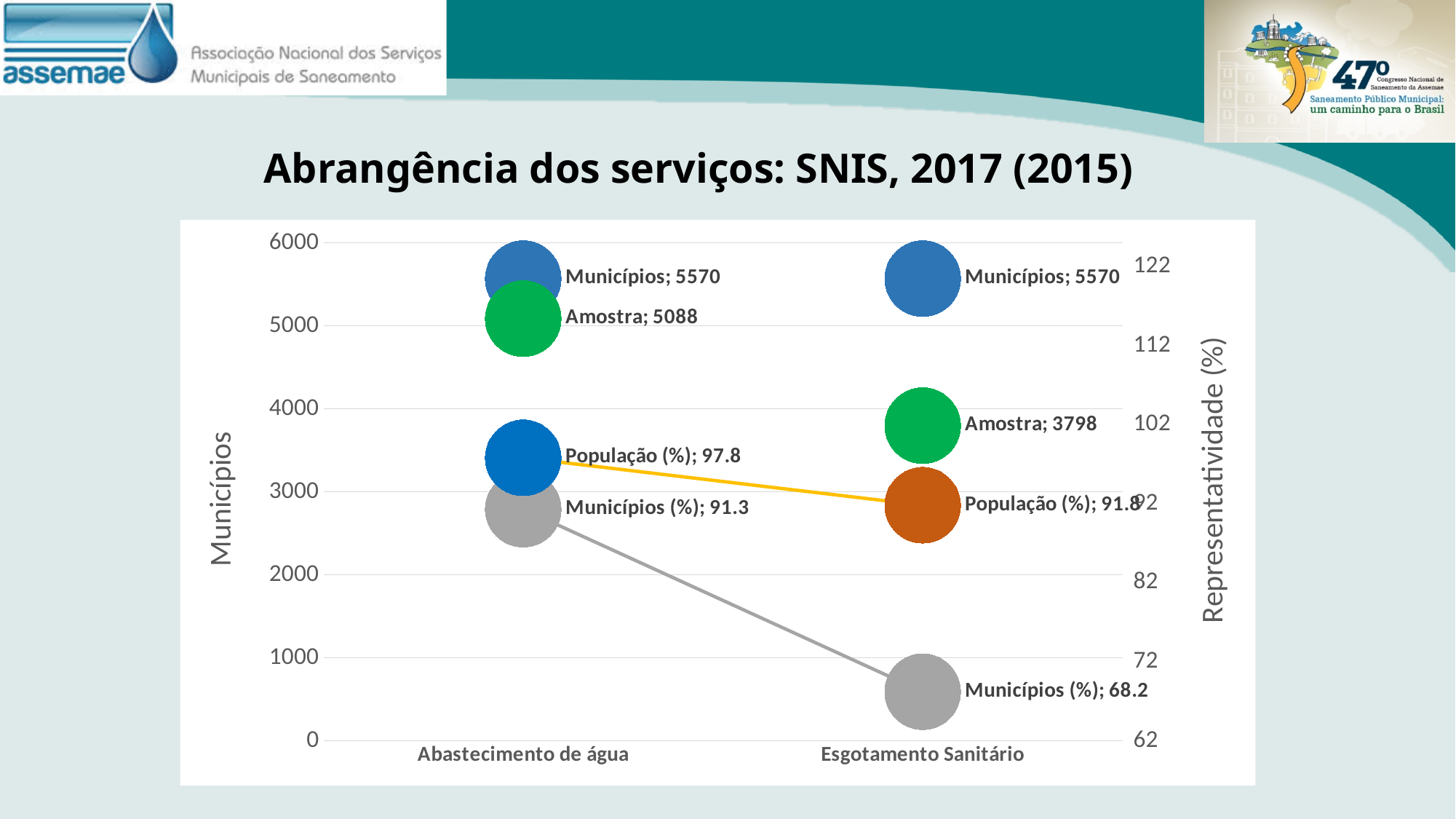
Does the Municípios (%) value rise or fall from Abastecimento de água to Esgotamento Sanitário? fall What is the difference between the Amostra values for Abastecimento de água and Esgotamento Sanitário? 1290 What is the value of Municípios for Esgotamento Sanitário? 5570 What is the Municípios (%) value for Esgotamento Sanitário? 68.2 What is the title of the slide's chart section? Abrangência dos serviços: SNIS, 2017 (2015) What is the Municípios (%) value for Abastecimento de água? 91.3 Which category has the larger Amostra value, Abastecimento de água or Esgotamento Sanitário? Abastecimento de água What is the value of Amostra for Esgotamento Sanitário? 3798 What is the População (%) value for Abastecimento de água? 97.8 What is the difference between the Municípios (%) values for Abastecimento de água and Esgotamento Sanitário? 23.1 What is the value of Amostra for Abastecimento de água? 5088 How many categories are shown on the x axis? 2